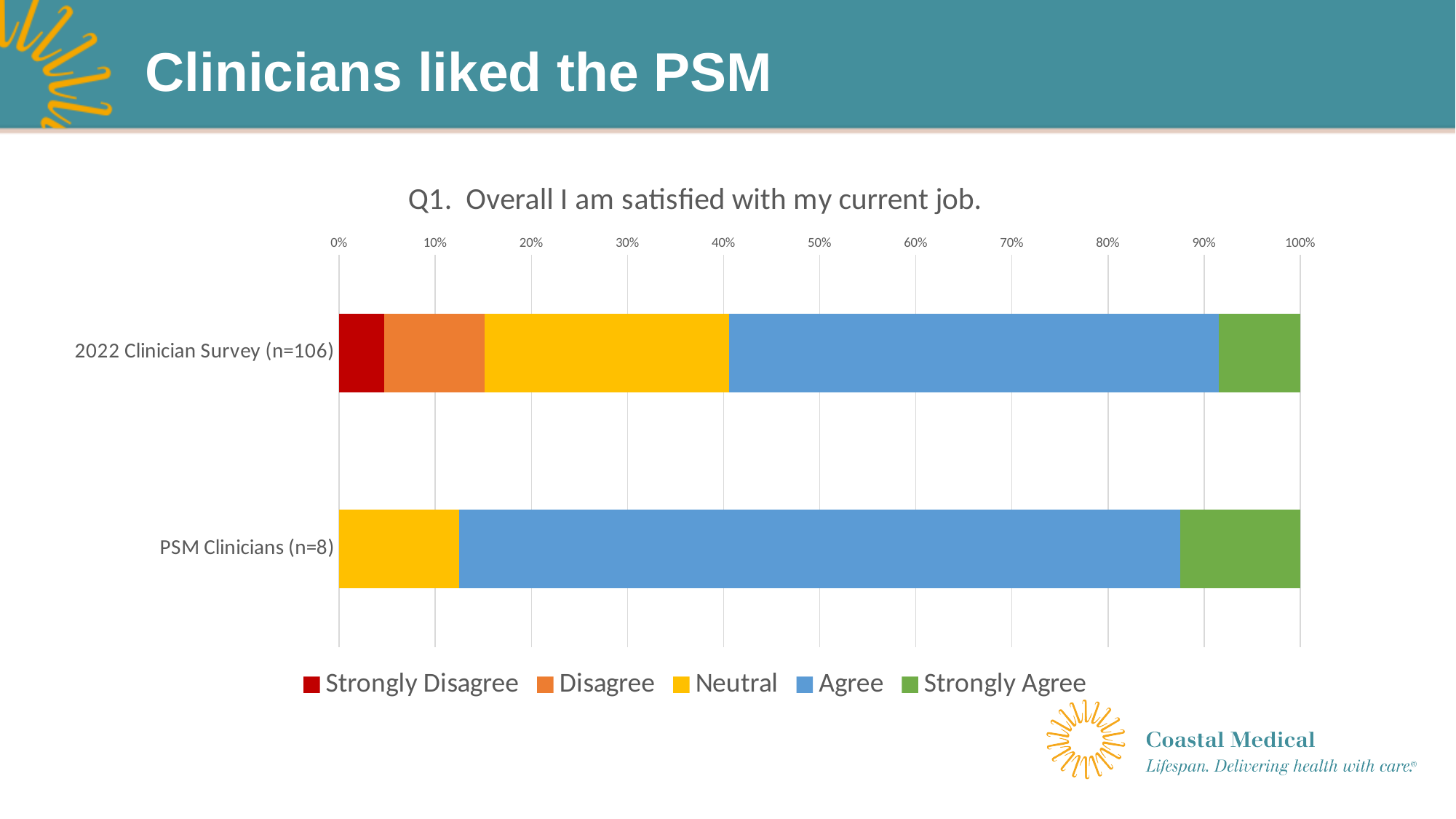
How many categories (bars) does the chart show? 2 Which group has the larger Neutral share: 2022 Clinician Survey (n=106) or PSM Clinicians (n=8)? 2022 Clinician Survey (n=106) How many series does the legend list? 5 Is the Agree share for the 2022 Clinician Survey (n=106) greater or less than 40%? greater What is the title of the chart? Q1. Overall I am satisfied with my current job. What kind of chart is shown on the slide? Stacked bar chart Is the Agree share for PSM Clinicians (n=8) greater or less than 60%? greater Which response category makes up the smallest share of the 2022 Clinician Survey (n=106) bar? Strongly Disagree Which group has the larger Agree share: 2022 Clinician Survey (n=106) or PSM Clinicians (n=8)? PSM Clinicians (n=8) Is the Neutral share for PSM Clinicians (n=8) greater or less than 20%? less Which response category is shown in blue in the legend? Agree Which response category makes up the largest share of the PSM Clinicians (n=8) bar? Agree